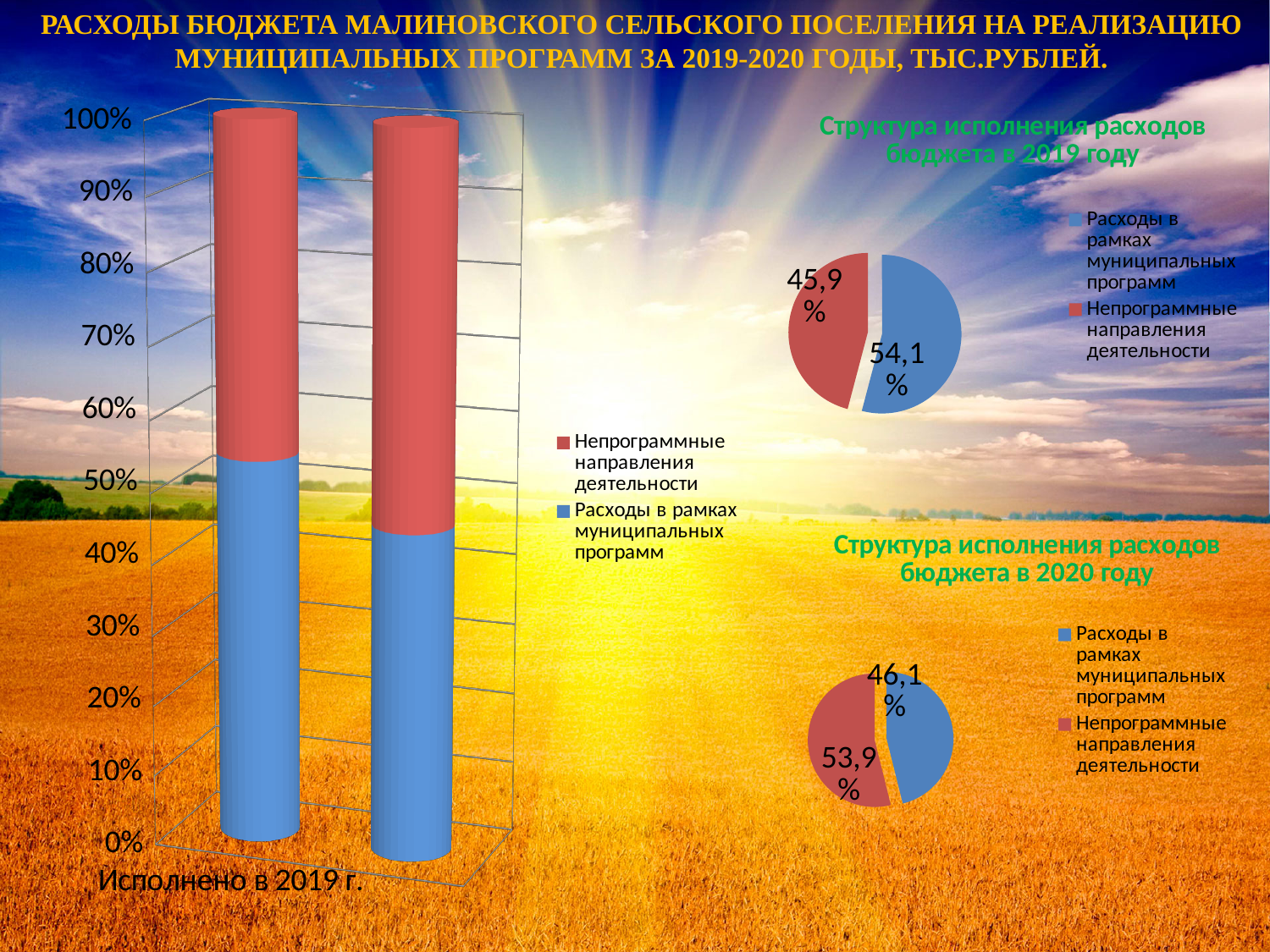
In the pie chart 'Структура исполнения расходов бюджета в 2020 году', what share is shown for 'Расходы в рамках муниципальных программ'? 46,1% In the pie chart 'Структура исполнения расходов бюджета в 2020 году', what is the difference between the two slices? 7,8% In the chart on the left side of the slide, is the 'Расходы в рамках муниципальных программ' segment of the bar 'Исполнено в 2019 г.' greater or less than 50%? greater In the pie chart 'Структура исполнения расходов бюджета в 2020 году', which slice is larger? Непрограммные направления деятельности How many series does the legend of the chart on the left side of the slide list? 2 In the pie chart 'Структура исполнения расходов бюджета в 2019 году', what is the difference between the two slices? 8,2% In the pie chart 'Структура исполнения расходов бюджета в 2019 году', which slice is larger? Расходы в рамках муниципальных программ What kind of chart is the chart on the left side of the slide? Stacked bar chart In the pie chart 'Структура исполнения расходов бюджета в 2020 году', what share is shown for 'Непрограммные направления деятельности'? 53,9% How many slices does the pie chart 'Структура исполнения расходов бюджета в 2019 году' have? 2 In the pie chart 'Структура исполнения расходов бюджета в 2019 году', what share is shown for 'Непрограммные направления деятельности'? 45,9%